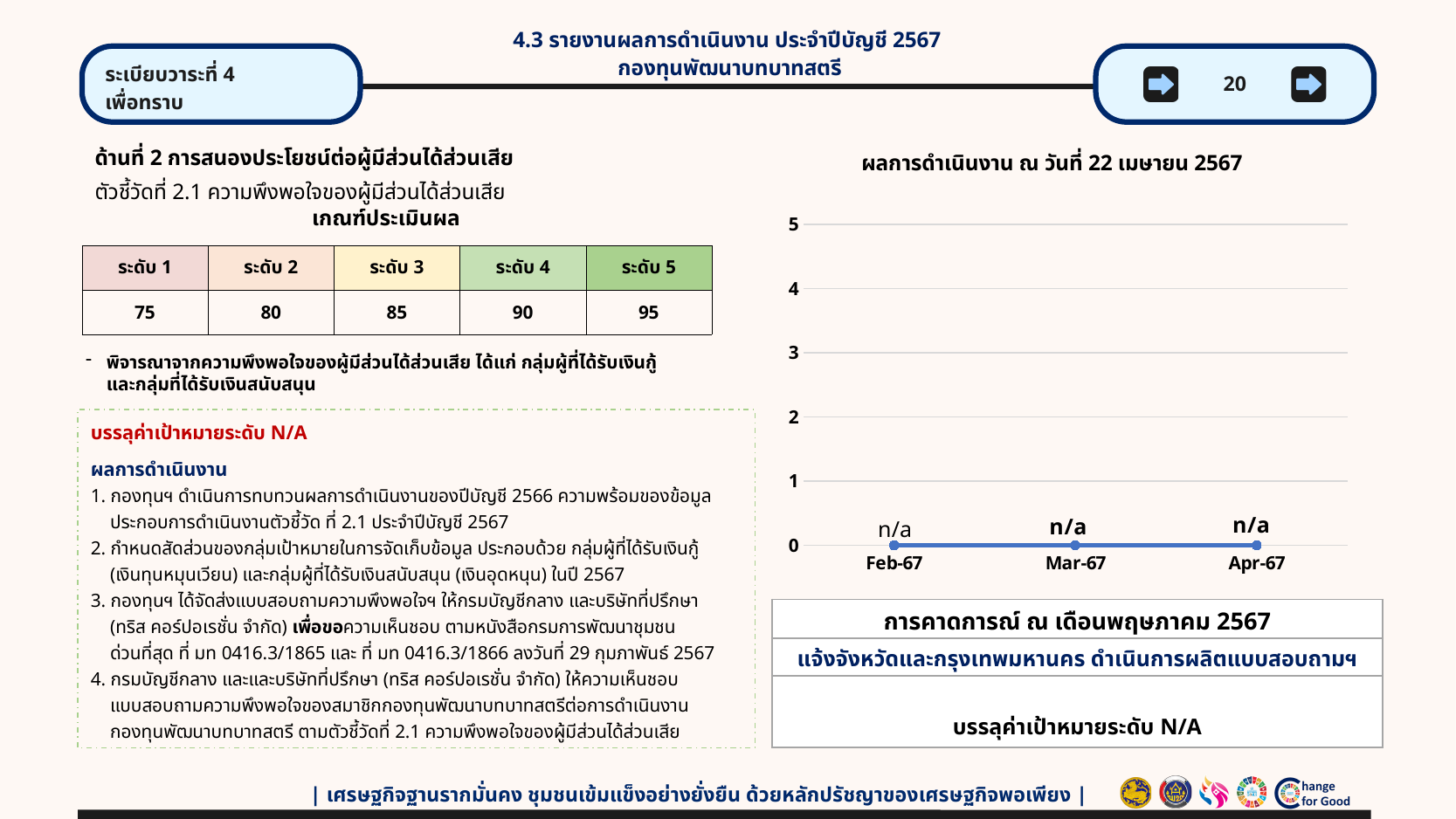
What is the title of the chart? ผลการดำเนินงาน ณ วันที่ 22 เมษายน 2567 What kind of chart is shown on the slide? line chart How many data points are plotted on the chart? 3 What is the highest value shown on the chart's vertical axis? 5 Is the plotted value for Feb-67 greater or less than 2? less What is the data label shown for Apr-67 on the chart? n/a What is the first category label on the chart's x axis? Feb-67 What is the last category label on the chart's x axis? Apr-67 Is the plotted value for Apr-67 greater or less than 1? less What is the data label shown for Feb-67 on the chart? n/a What is the data label shown for Mar-67 on the chart? n/a Do the plotted values rise, fall, or stay flat from Feb-67 to Apr-67? stay flat